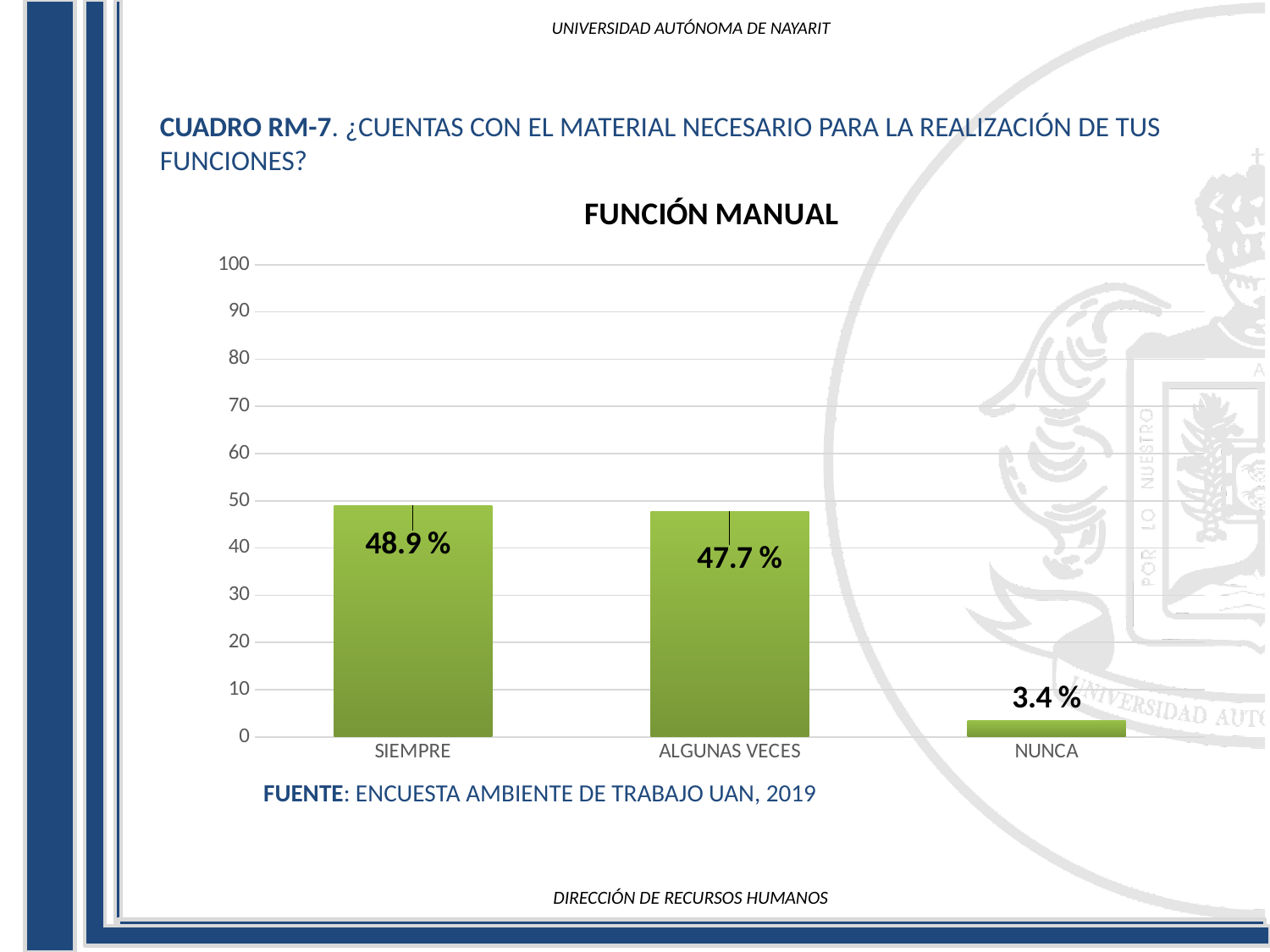
How many categories are shown on the x axis? 3 What kind of chart is shown on the slide? bar chart What is the difference between the values for ALGUNAS VECES and NUNCA? 44.3 % Which category has the lowest value? NUNCA Which is larger, the value for ALGUNAS VECES or the value for NUNCA? ALGUNAS VECES What is the value for NUNCA? 3.4 % What is the value for ALGUNAS VECES? 47.7 % What is the difference between the values for SIEMPRE and ALGUNAS VECES? 1.2 % What is the value for SIEMPRE? 48.9 % What is the title of the chart? FUNCIÓN MANUAL Which category has the highest value? SIEMPRE Is the value for SIEMPRE greater or less than 50? less